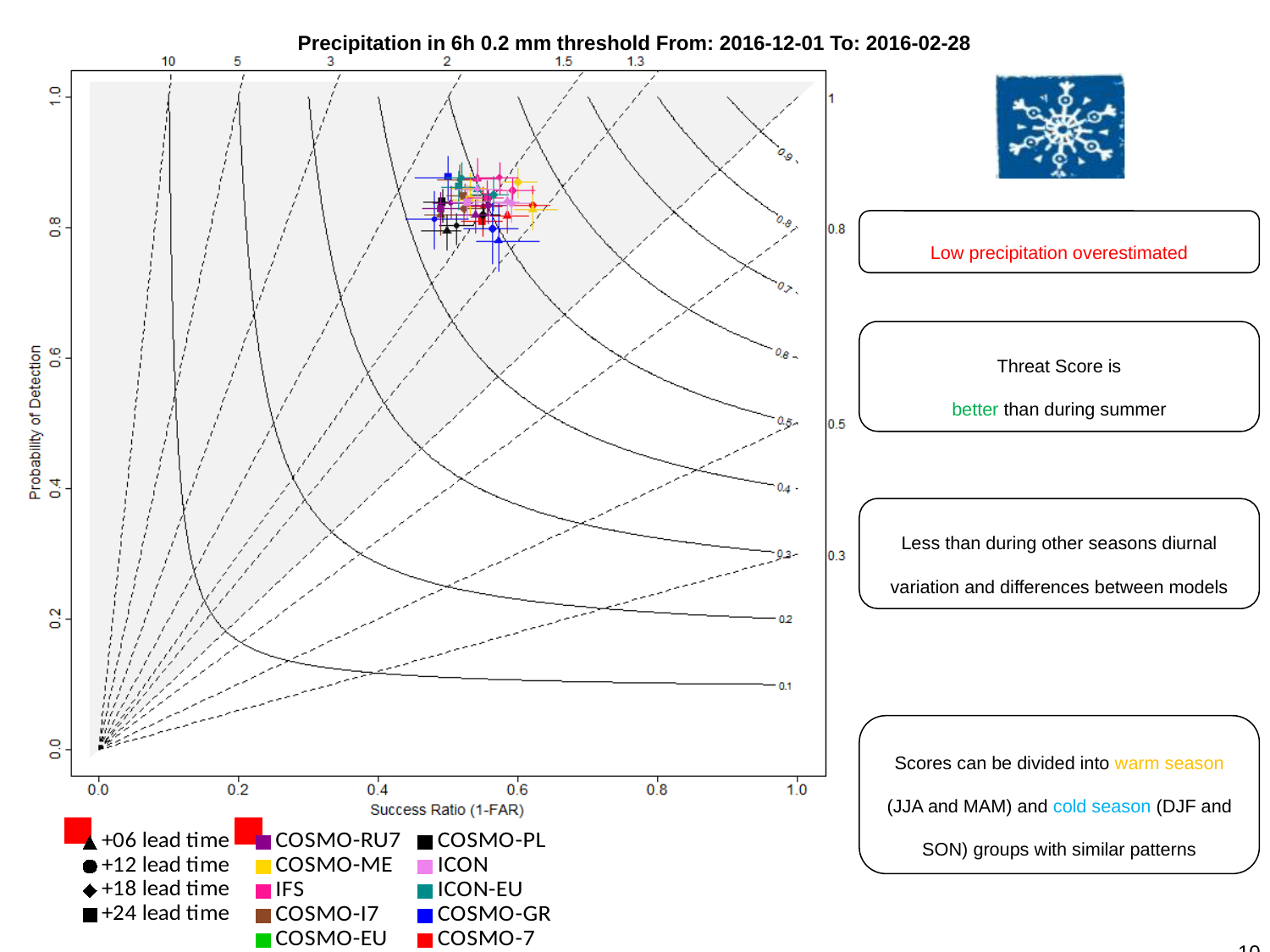
What is the title of the chart? Precipitation in 6h 0.2 mm threshold From: 2016-12-01 To: 2016-02-28 What kind of chart is shown on the slide? scatter plot Is the Success Ratio of the plotted points greater or less than 0.2? greater Is the Probability of Detection of the plotted points greater or less than 1.0? less What is the label of the x axis of the chart? Success Ratio (1-FAR) How many models are listed in the chart's legend? 10 How many lead times are listed in the chart's legend? 4 Is the Probability of Detection of the plotted points greater or less than 0.4? greater